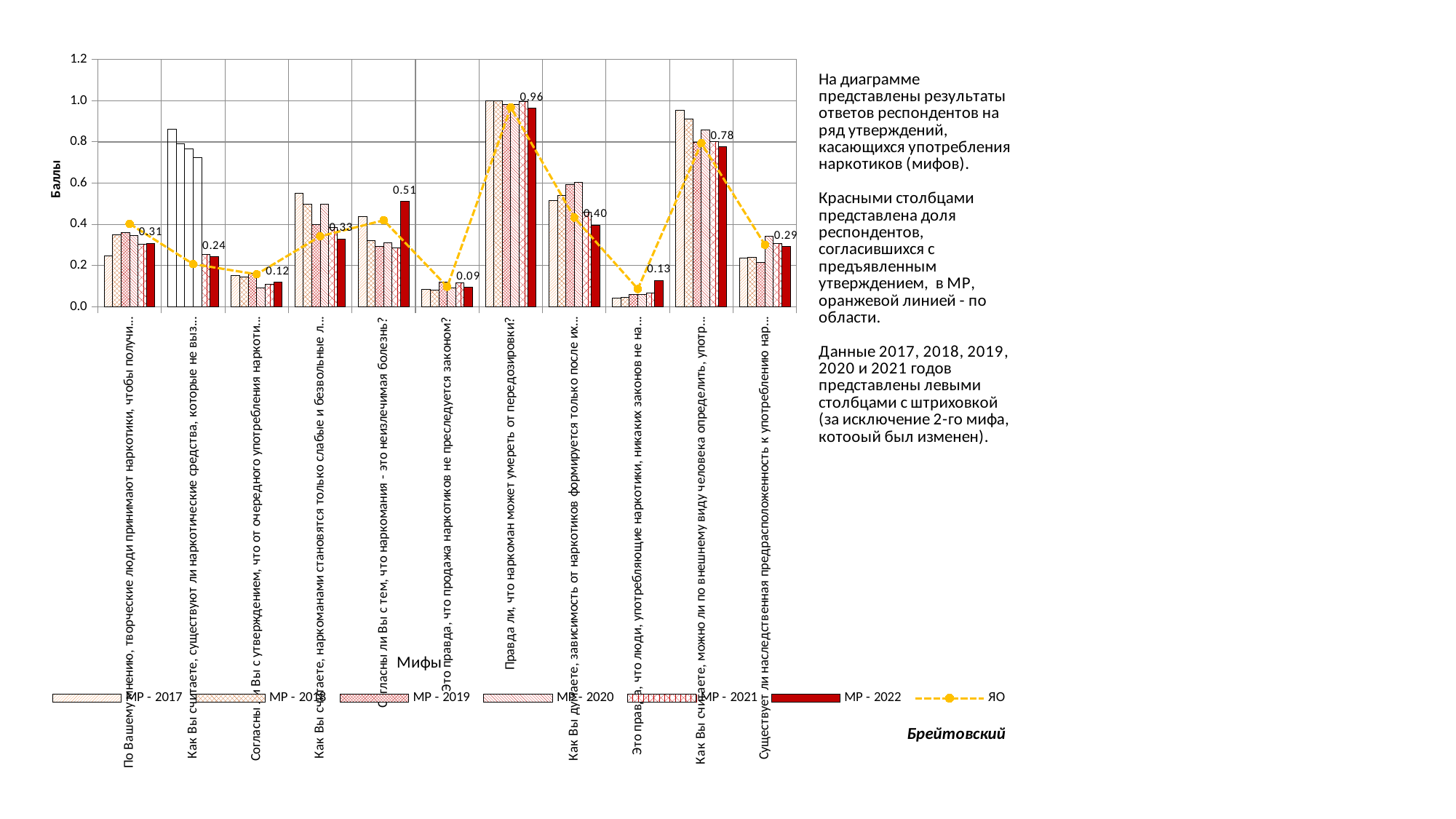
What is the title of the vertical axis of the chart? Баллы How many series does the chart legend list? 7 Is the МР - 2022 value for "Правда ли, что наркоман может умереть от передозировки?" greater or less than 0.8? greater Which has a larger ЯО value: "Согласны ли Вы с тем, что наркомания - это неизлечимая болезнь?" or "Как Вы считаете, наркоманами становятся только слабые и безвольные л..."? Согласны ли Вы с тем, что наркомания - это неизлечимая болезнь? How many myths (categories) are shown on the x axis of the chart? 11 Is the МР - 2022 value for "Это правда, что продажа наркотиков не преследуется законом?" greater or less than 0.2? less For which myth is the ЯО line value the highest? Правда ли, что наркоман может умереть от передозировки?